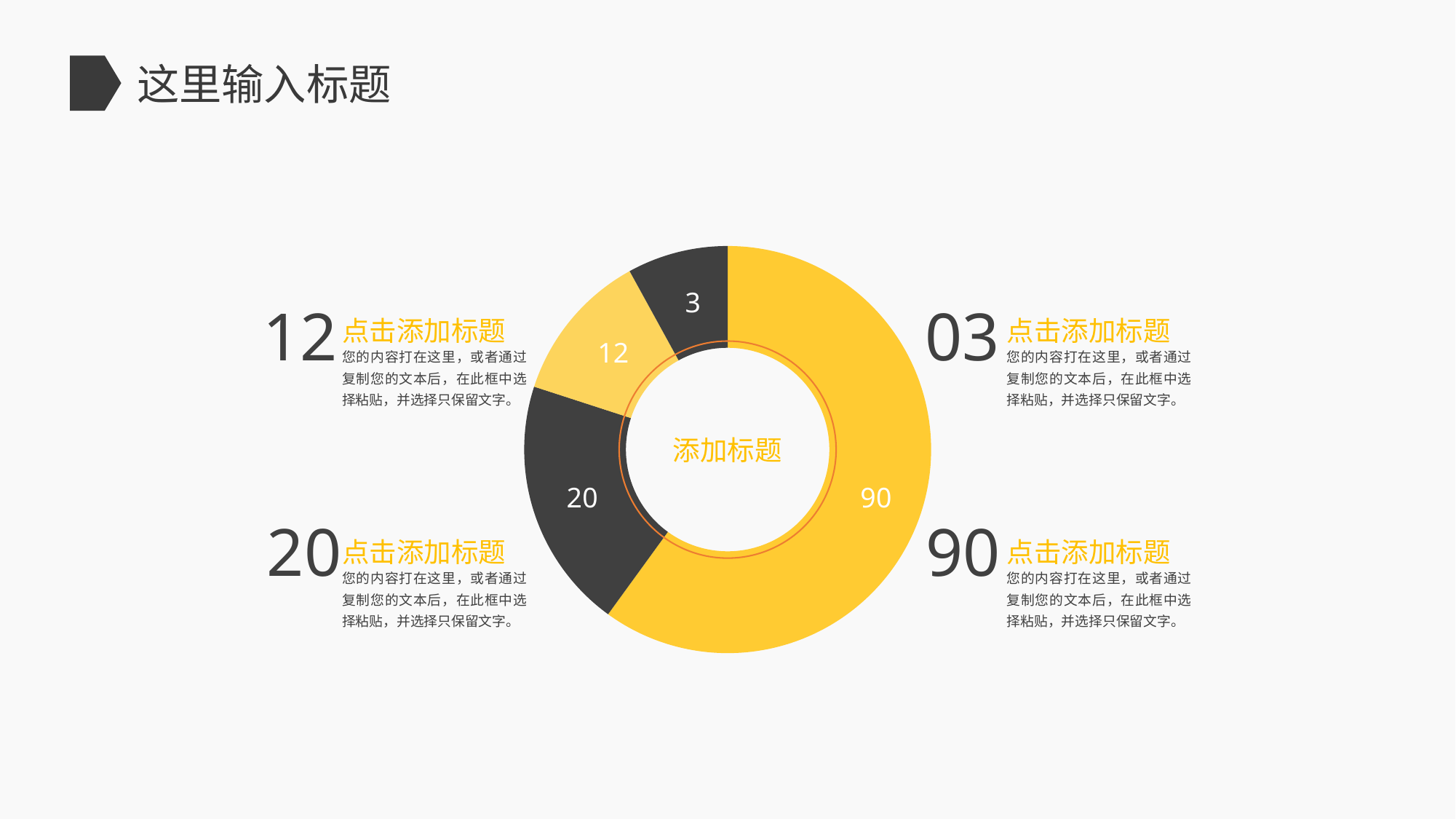
What is the difference between the slice labelled 90 and the slice labelled 20? 70 What value is labelled on the large dark grey slice on the left of the doughnut? 20 Which slice is larger, the one labelled 12 or the one labelled 3? 12 What is the smallest value labelled on the doughnut chart? 3 What value is labelled on the small dark grey slice at the top of the doughnut? 3 What kind of chart is shown on the slide? Doughnut (pie) chart What is the largest value labelled on the doughnut chart? 90 How many slices does the doughnut chart have? 4 What is the total of all four slice values in the doughnut chart? 125 What text is shown in the centre of the doughnut chart? 添加标题 What value is labelled on the light yellow slice at the upper left of the doughnut? 12